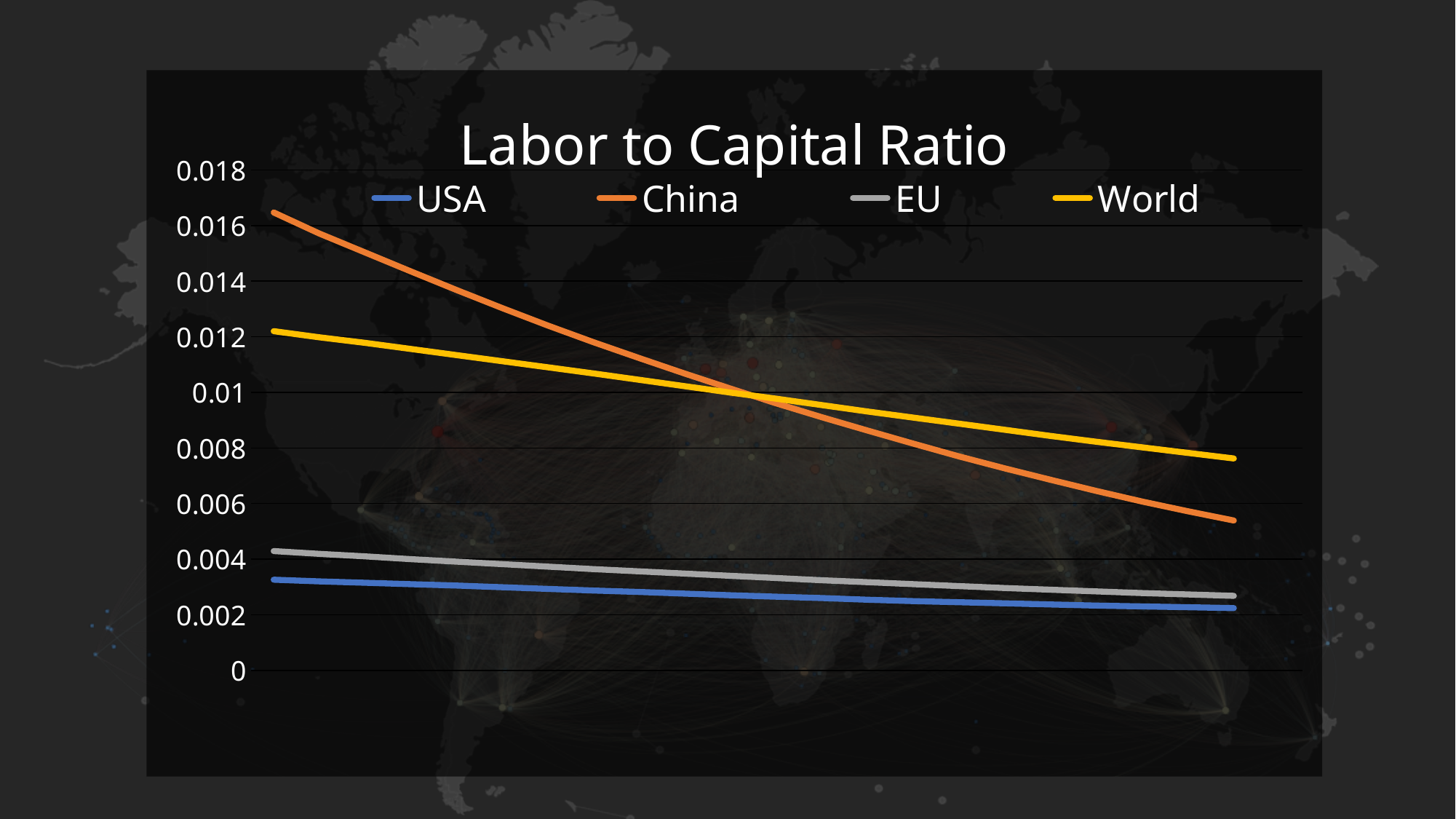
Is the value of the World line at the right end of the chart greater or less than 0.008? less What kind of chart is shown on the slide? line chart Which series has the lowest value across the chart? USA Which series has the highest value at the left end of the chart? China How many series does the legend list? 4 Which series is plotted in orange? China Does the World line rise or fall from left to right? fall Does the China line rise or fall from left to right? fall At the right end of the chart, which is larger, the World line or the China line? World What is the title of the chart? Labor to Capital Ratio Is the value of the USA line at the left end of the chart greater or less than 0.004? less Is the value of the China line at the left end of the chart greater or less than 0.014? greater